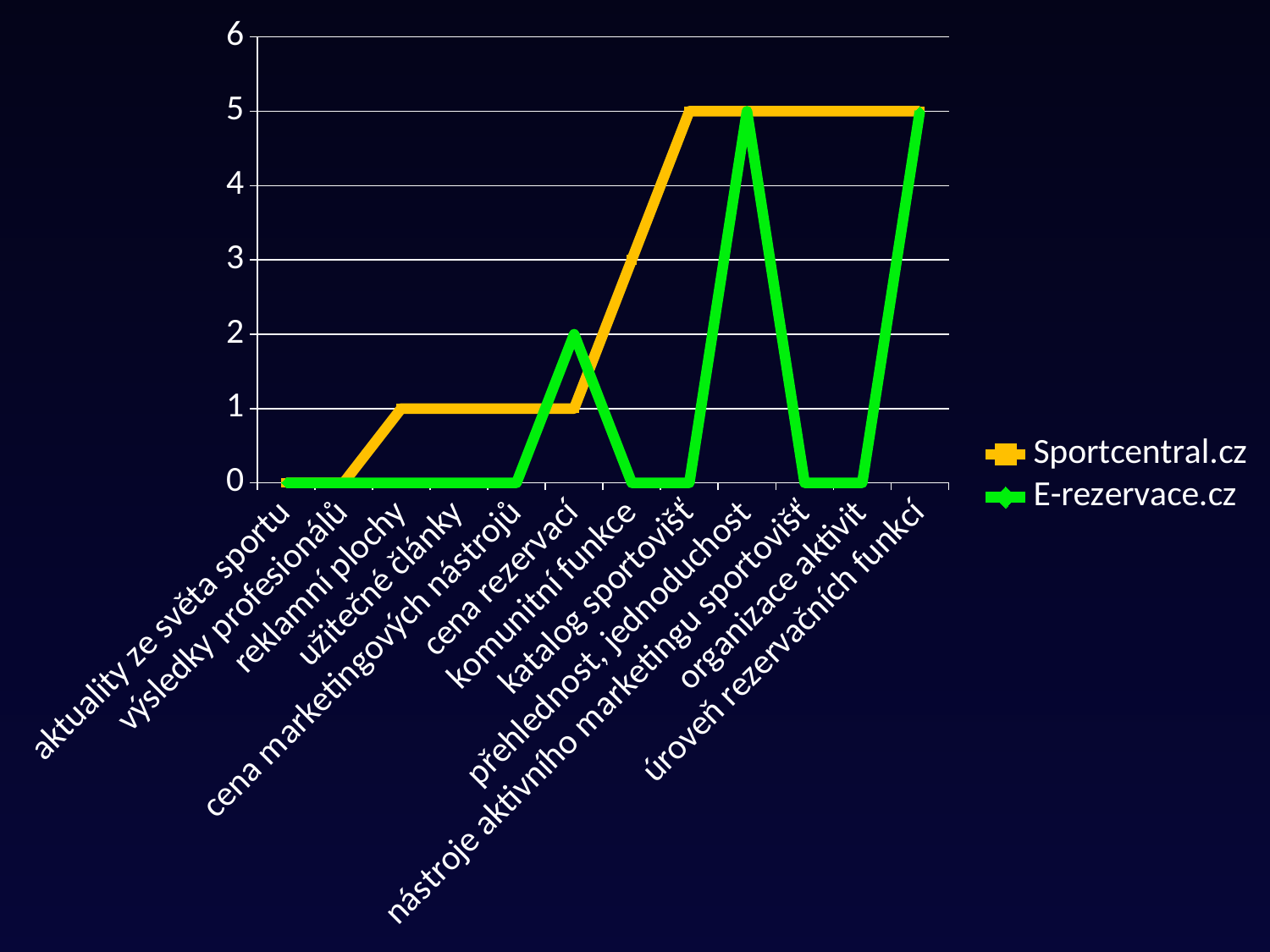
What kind of chart is shown on the slide? line chart Is the value for Sportcentral.cz at 'komunitní funkce' greater or less than 2? greater What is the value for E-rezervace.cz at 'přehlednost, jednoduchost'? 5 Which colour is used for the E-rezervace.cz series? green How many series does the legend list? 2 What is the value for E-rezervace.cz at 'organizace aktivit'? 0 What is the value for E-rezervace.cz at 'cena rezervací'? 2 What is the value for Sportcentral.cz at 'reklamní plochy'? 1 What is the value for Sportcentral.cz at 'katalog sportovišť'? 5 How many categories are shown on the x axis? 12 What is the difference between Sportcentral.cz and E-rezervace.cz at 'nástroje aktivního marketingu sportovišť'? 5 Which series has the higher value at 'cena rezervací'? E-rezervace.cz